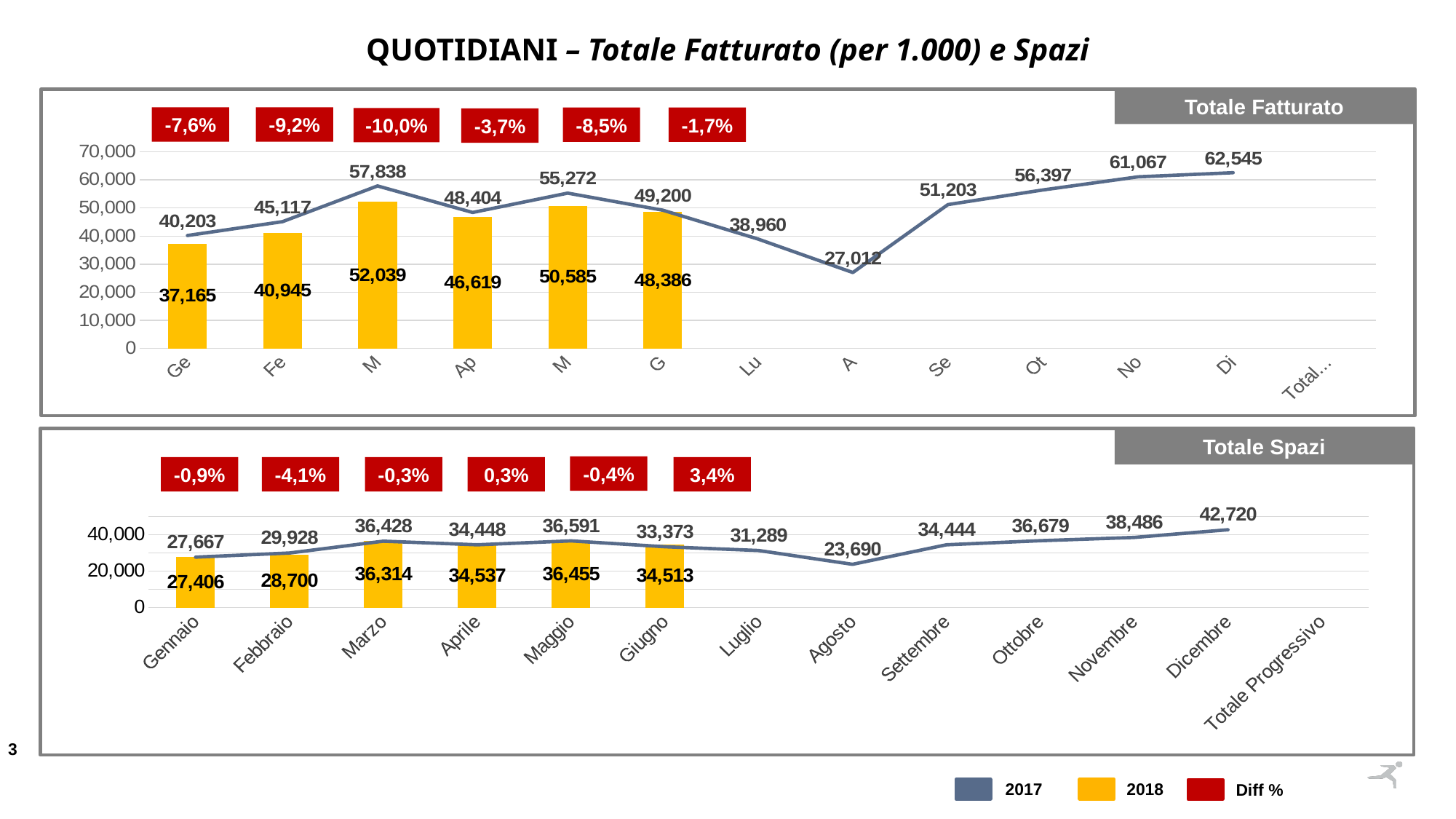
In the Totale Fatturato chart, which month has the lowest 2017 value? A In the Totale Spazi chart, which month has the highest 2017 value? Dicembre In the Totale Spazi chart, is the 2017 value for Agosto greater or less than 20,000? greater In the Totale Spazi chart, is the 2017 value for Aprile or the 2018 value for Aprile larger? 2018 How many series does the legend at the bottom of the slide list? 3 In the Totale Spazi chart, how many 2018 bars are plotted? 6 In the Totale Fatturato chart, what is the 2017 value for Di? 62,545 In the Totale Fatturato chart, what is the difference between the 2017 and 2018 values for M (the third category)? 5,799 In the Totale Fatturato chart, what is the 2018 value for Ge? 37,165 In the Totale Fatturato chart, what Diff % is shown above the Fe category? -9,2% In the Totale Spazi chart, what is the 2018 value for Giugno? 34,513 In the Totale Fatturato chart, does the 2017 line rise or fall from Se to Di? rise